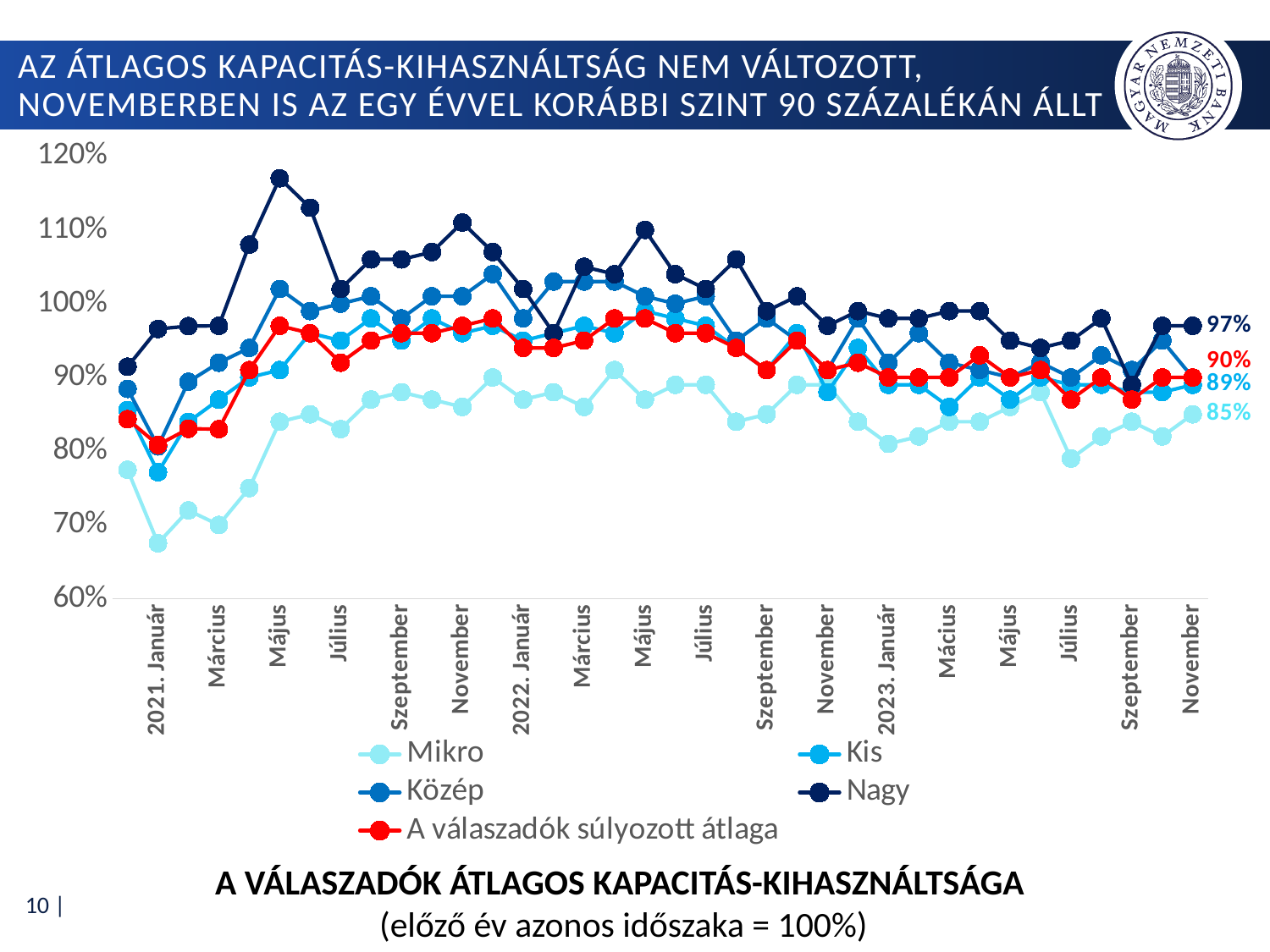
What is the value for the Nagy series in November 2023? 97% What is the difference between the Nagy and Mikro values in November 2023? 12 percentage points Which legend entry is drawn in red? A válaszadók súlyozott átlaga What is the value for 'A válaszadók súlyozott átlaga' in November 2023? 90% What is the value for the Mikro series in November 2023? 85% How many series does the legend list? 5 What type of chart is shown on the slide? Line chart Is the value for the Nagy series in May 2021 (Május) greater or less than 110%? greater What is the difference between the Nagy value and the weighted average ('A válaszadók súlyozott átlaga') in November 2023? 7 percentage points Which series has the lowest value in November 2023? Mikro Which series has the highest value in November 2023? Nagy Is the value for the Mikro series in 2021. Január greater or less than 80%? less